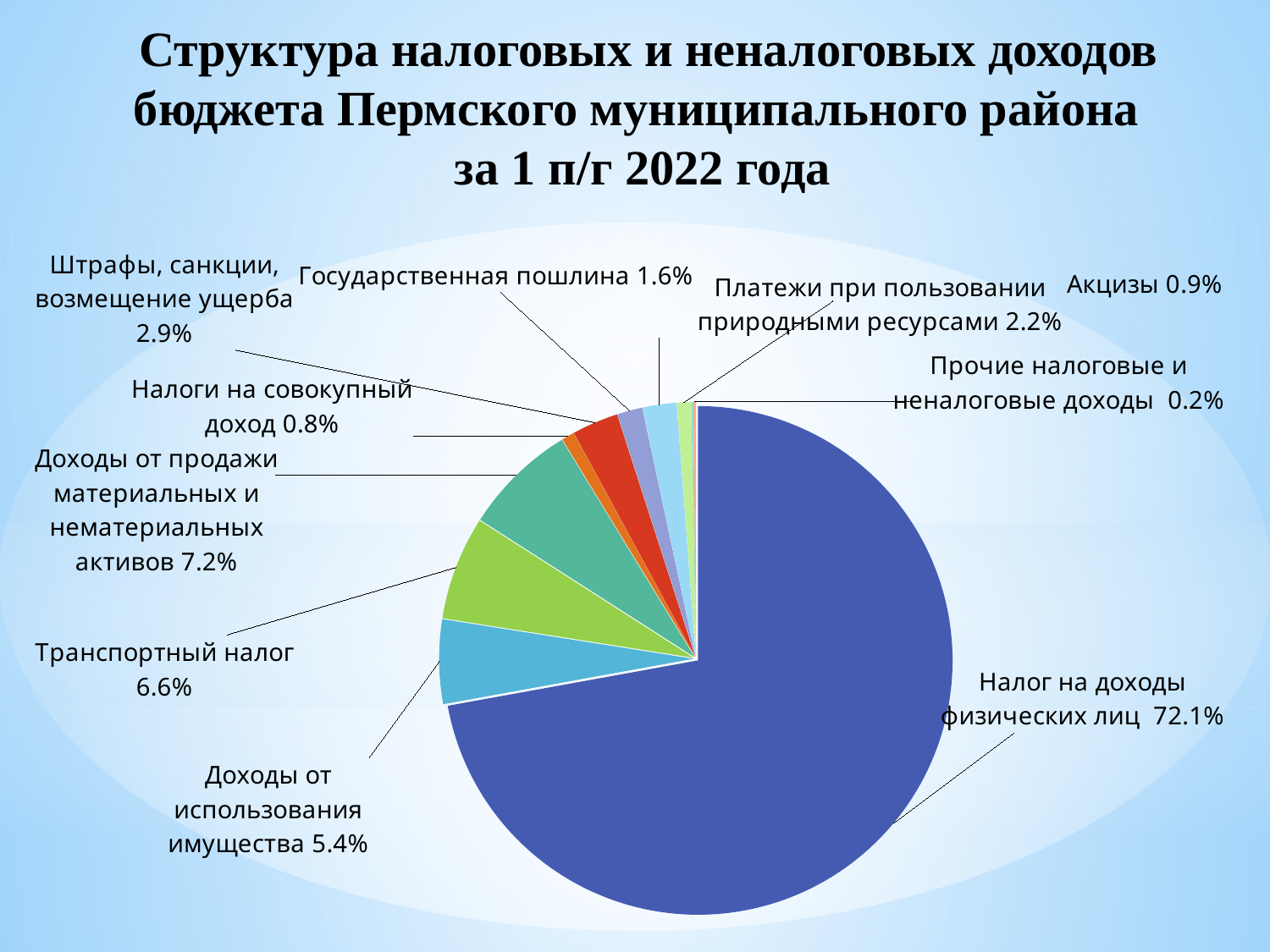
What is the value shown for Транспортный налог? 6.6% What period does the slide title say the data covers? 1 п/г 2022 года How many categories (slices) does the pie chart have? 11 What is the value shown for Акцизы? 0.9% Which is larger: Транспортный налог or Доходы от использования имущества? Транспортный налог What is the difference between the shares of Штрафы, санкции, возмещение ущерба and Государственная пошлина? 1.3% Which category has the largest share of the pie? Налог на доходы физических лиц What share of the pie is Налог на доходы физических лиц? 72.1% What is the value shown for Доходы от продажи материальных и нематериальных активов? 7.2% What kind of chart is shown on the slide? pie chart What is the value shown for Платежи при пользовании природными ресурсами? 2.2%